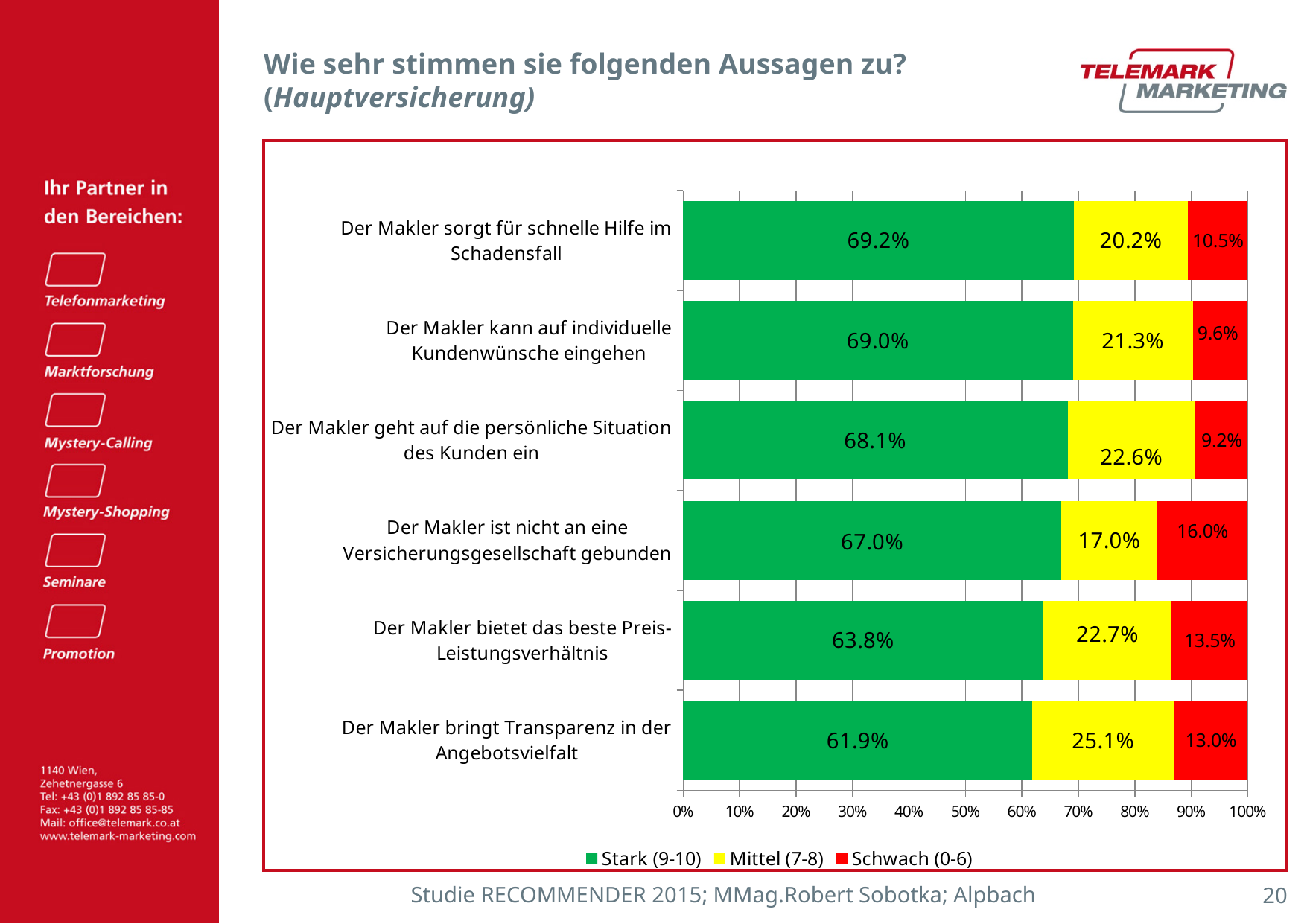
Which colour represents the 'Schwach (0-6)' series in the chart? Red Which is larger: the 'Mittel (7-8)' share for 'Der Makler bietet das beste Preis-Leistungsverhältnis' or for 'Der Makler ist nicht an eine Versicherungsgesellschaft gebunden'? Der Makler bietet das beste Preis-Leistungsverhältnis What is the total of the stacked bar for 'Der Makler bietet das beste Preis-Leistungsverhältnis'? 100.0% What is the 'Mittel (7-8)' value for 'Der Makler bringt Transparenz in der Angebotsvielfalt'? 25.1% How many series does the legend list? 3 Which statement has the lowest 'Stark (9-10)' share? Der Makler bringt Transparenz in der Angebotsvielfalt How many statements (categories) are shown in the chart? 6 What is the difference in 'Stark (9-10)' share between 'Der Makler sorgt für schnelle Hilfe im Schadensfall' and 'Der Makler bringt Transparenz in der Angebotsvielfalt'? 7.3 percentage points Which statement has the highest 'Schwach (0-6)' share? Der Makler ist nicht an eine Versicherungsgesellschaft gebunden What is the 'Schwach (0-6)' value for 'Der Makler ist nicht an eine Versicherungsgesellschaft gebunden'? 16.0% What is the 'Stark (9-10)' value for 'Der Makler sorgt für schnelle Hilfe im Schadensfall'? 69.2% What type of chart is shown on the slide? Stacked bar chart